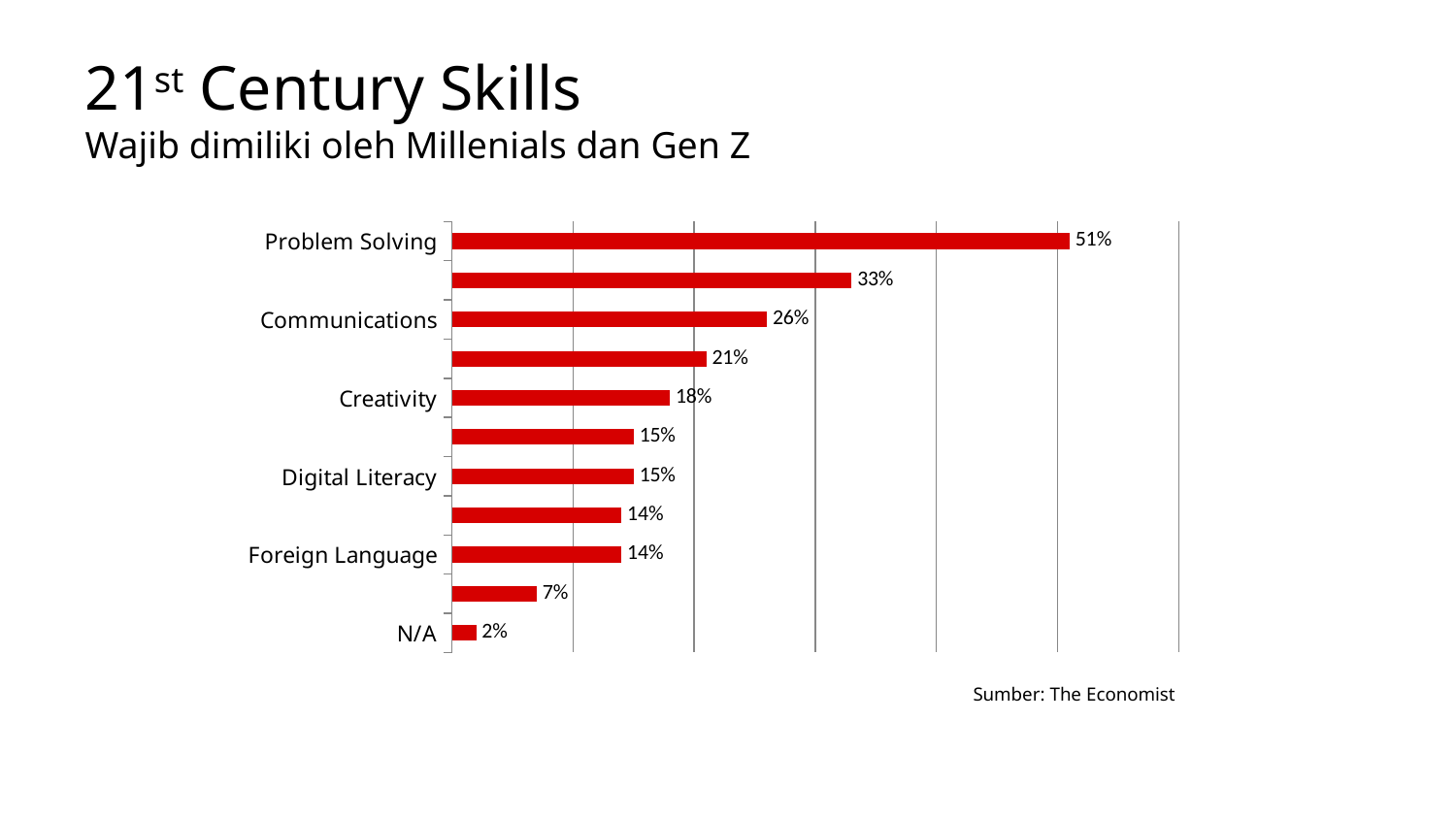
Which is larger, the value for Creativity or the value for Foreign Language? Creativity What is the value for Creativity? 18% What is the value for Problem Solving? 51% What is the value for Foreign Language? 14% What is the value for Communications? 26% What is the value for N/A? 2% What is the value for Digital Literacy? 15% Which category has the highest value? Problem Solving How many bars are plotted in the chart? 11 Which category has the lowest value? N/A What kind of chart is shown on the slide? Bar chart What is the difference between the values for Problem Solving and Communications? 25%